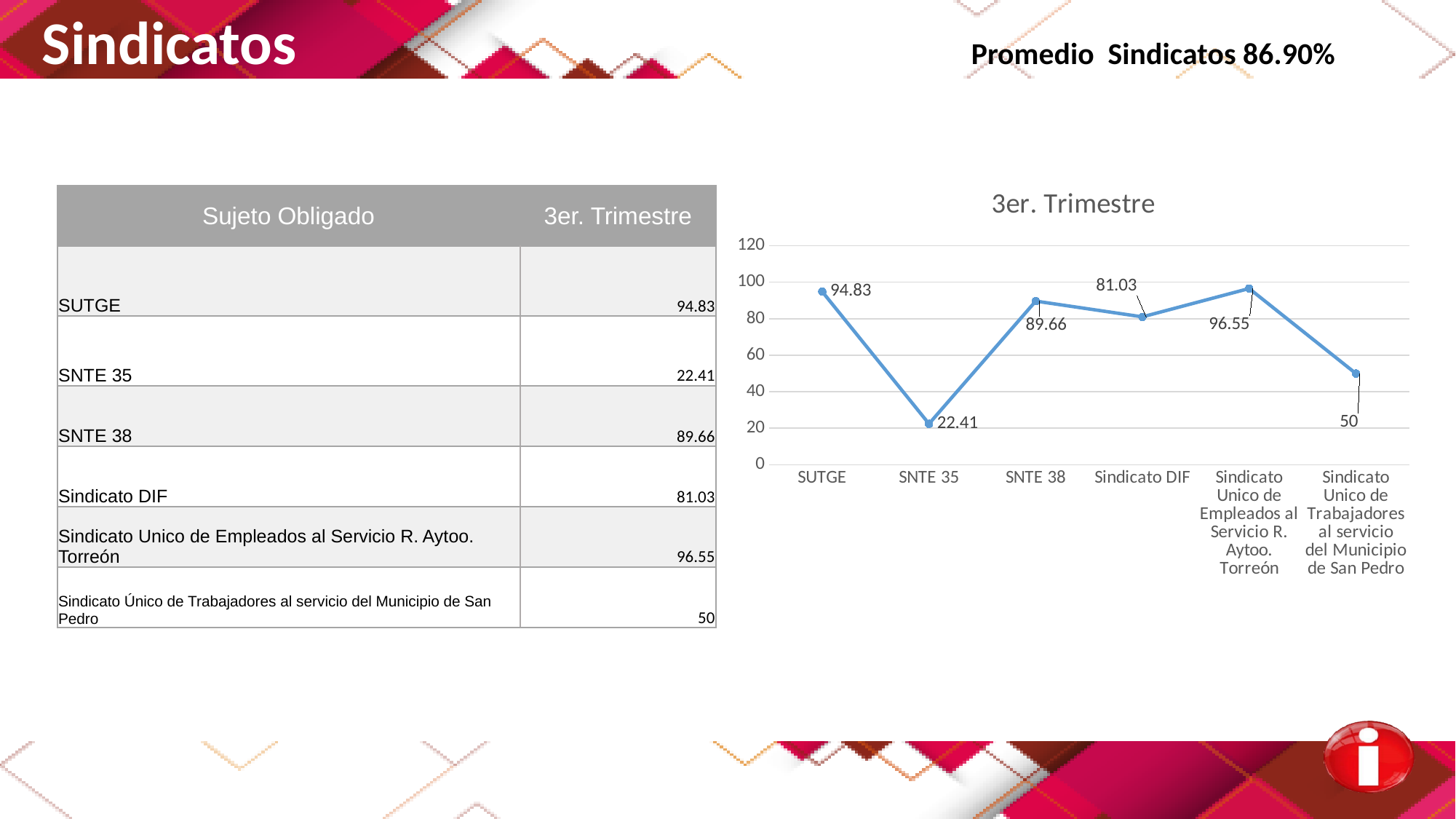
Which is larger, the value for SNTE 38 or the value for Sindicato DIF? SNTE 38 What is the value for Sindicato DIF in the 3er. Trimestre chart? 81.03 What is the value for SNTE 35 in the 3er. Trimestre chart? 22.41 What kind of chart is shown on the slide? line chart Which category has the lowest value in the 3er. Trimestre chart? SNTE 35 Is the value for Sindicato DIF greater or less than 100? less What is the value for SUTGE in the 3er. Trimestre chart? 94.83 What is the title of the chart? 3er. Trimestre How many categories are plotted on the x axis of the chart? 6 Which category has the highest value in the 3er. Trimestre chart? Sindicato Unico de Empleados al Servicio R. Aytoo. Torreón What is the value for Sindicato Unico de Trabajadores al servicio del Municipio de San Pedro in the chart? 50 What is the difference between the values for SUTGE and SNTE 35? 72.42